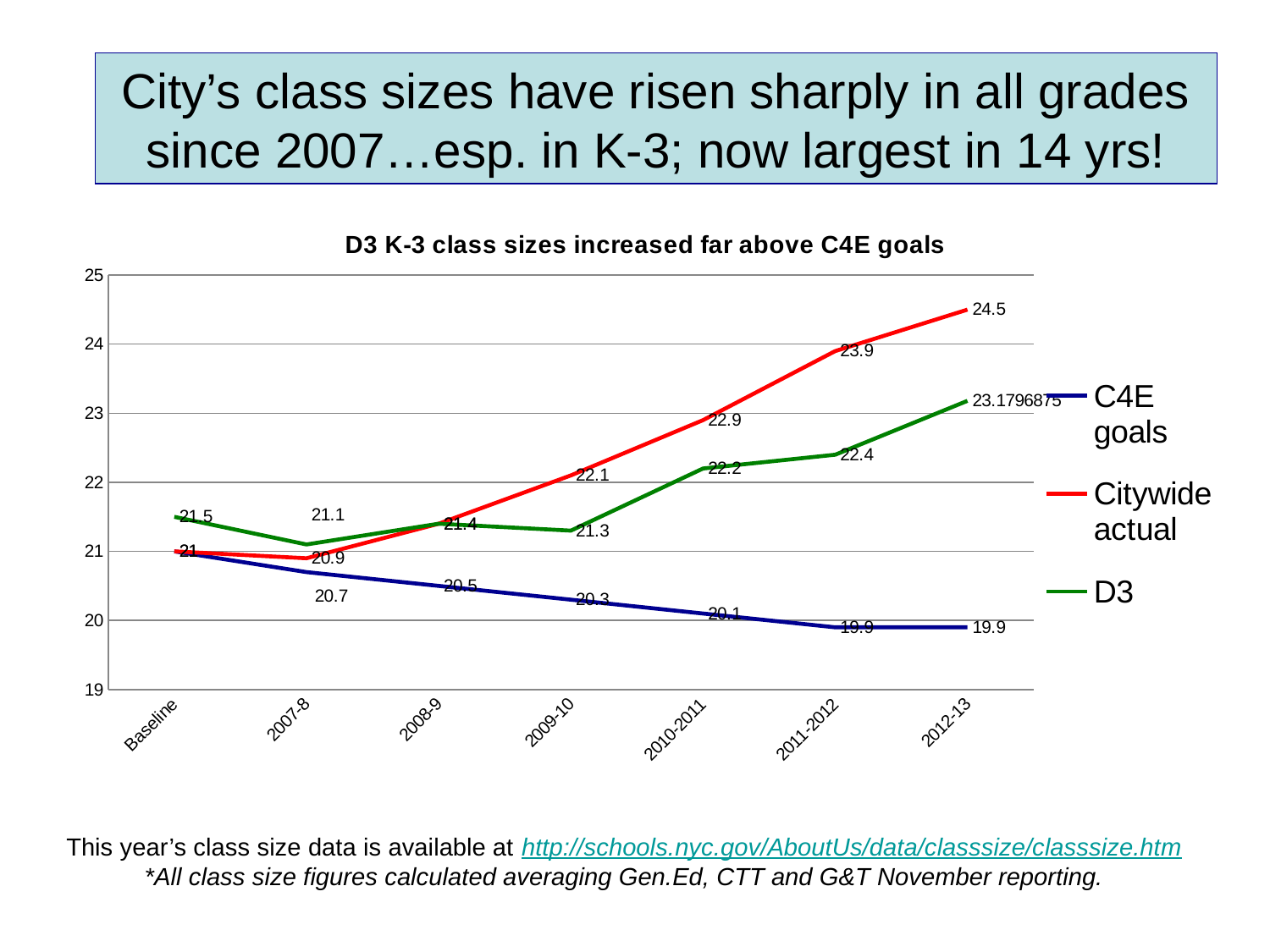
How many points are plotted along the x axis for each series? 7 Do the C4E goals values rise or fall from Baseline to 2012-13? fall What colour is the D3 line? green What kind of chart is shown on the slide? line chart What is the D3 value at Baseline? 21.5 What is the D3 value for 2012-13? 23.1796875 What is the C4E goals value for 2011-2012? 19.9 What is the difference between the Citywide actual value and the C4E goals value in 2012-13? 4.6 What is the Citywide actual value for 2012-13? 24.5 In 2010-2011, which is larger: the Citywide actual value or the D3 value? Citywide actual How many series does the legend list? 3 In which year does the Citywide actual series reach its highest value? 2012-13